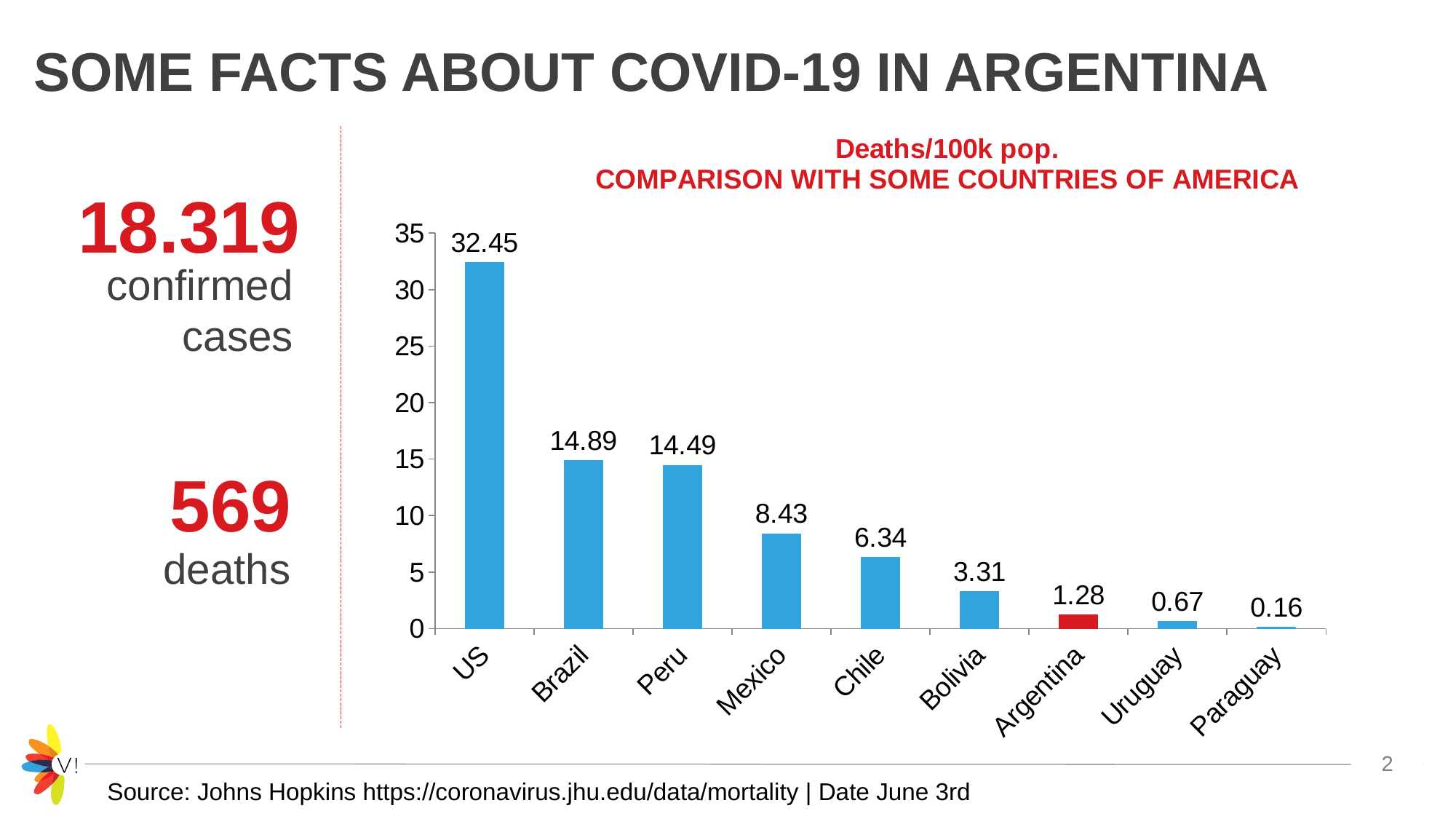
How many countries are shown in the chart? 9 What is the deaths per 100k population value for Brazil? 14.89 What is the deaths per 100k population value for Argentina? 1.28 What is the difference between the US value and the Brazil value? 17.56 Which country has the lowest deaths per 100k population? Paraguay What type of chart is shown on the slide? bar chart Which country has the highest deaths per 100k population? US Is the value for Mexico greater or less than 10? less What is the deaths per 100k population value for Chile? 6.34 Which has a higher deaths per 100k value, Brazil or Peru? Brazil What is the difference between the Mexico value and the Bolivia value? 5.12 Which country's bar is coloured red instead of blue? Argentina